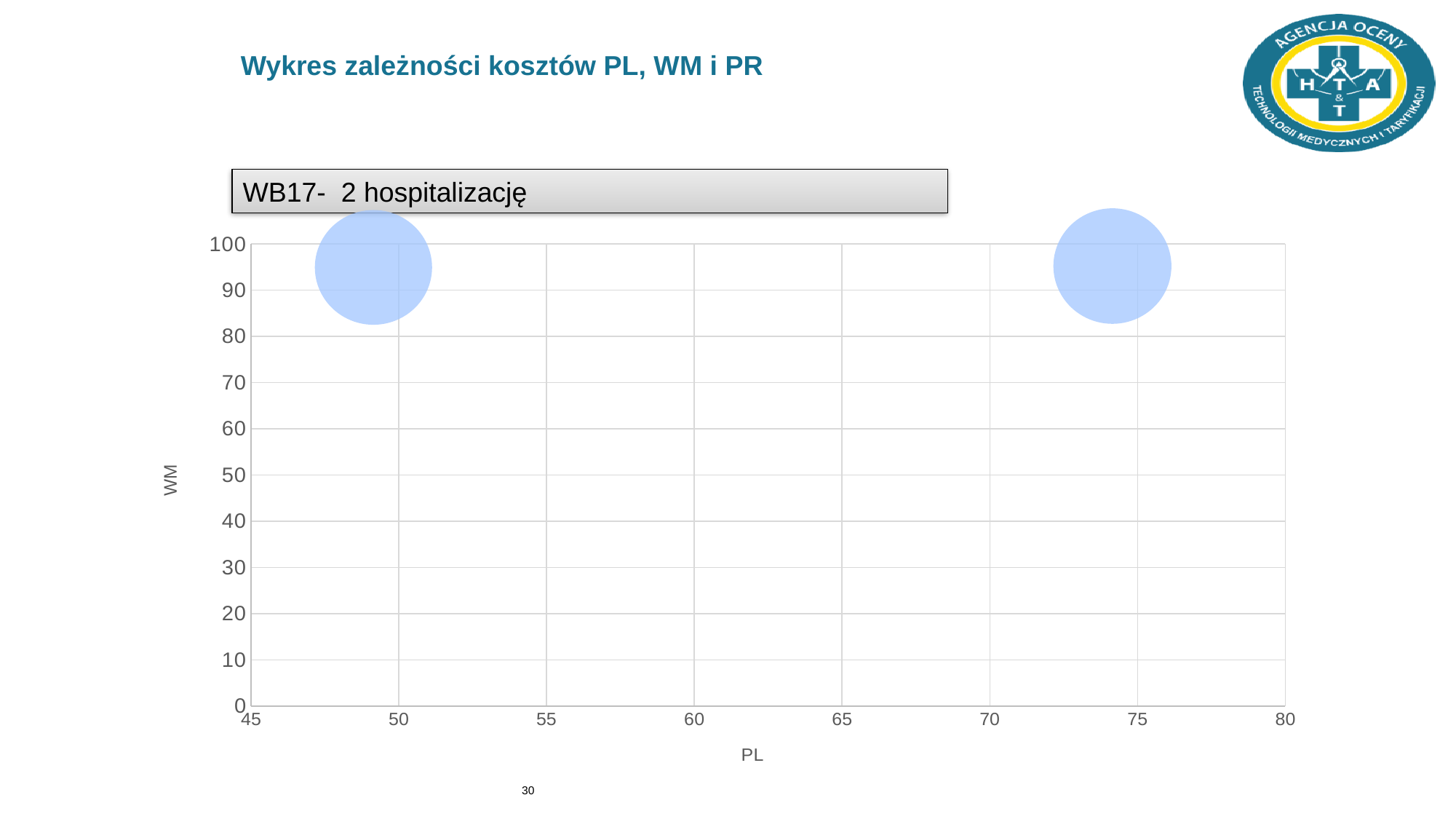
What is the label of the x axis? PL Is the PL value of the right bubble greater or less than 70? greater Is the WM value of the right bubble greater or less than 80? greater How many bubbles are plotted on the chart? 2 What is the highest value shown on the WM axis? 100 Is the PL value of the left bubble greater or less than 45? greater What is the label of the y axis? WM What kind of chart is shown on the slide? bubble chart Which bubble has the higher PL value, the left one or the right one? the right one